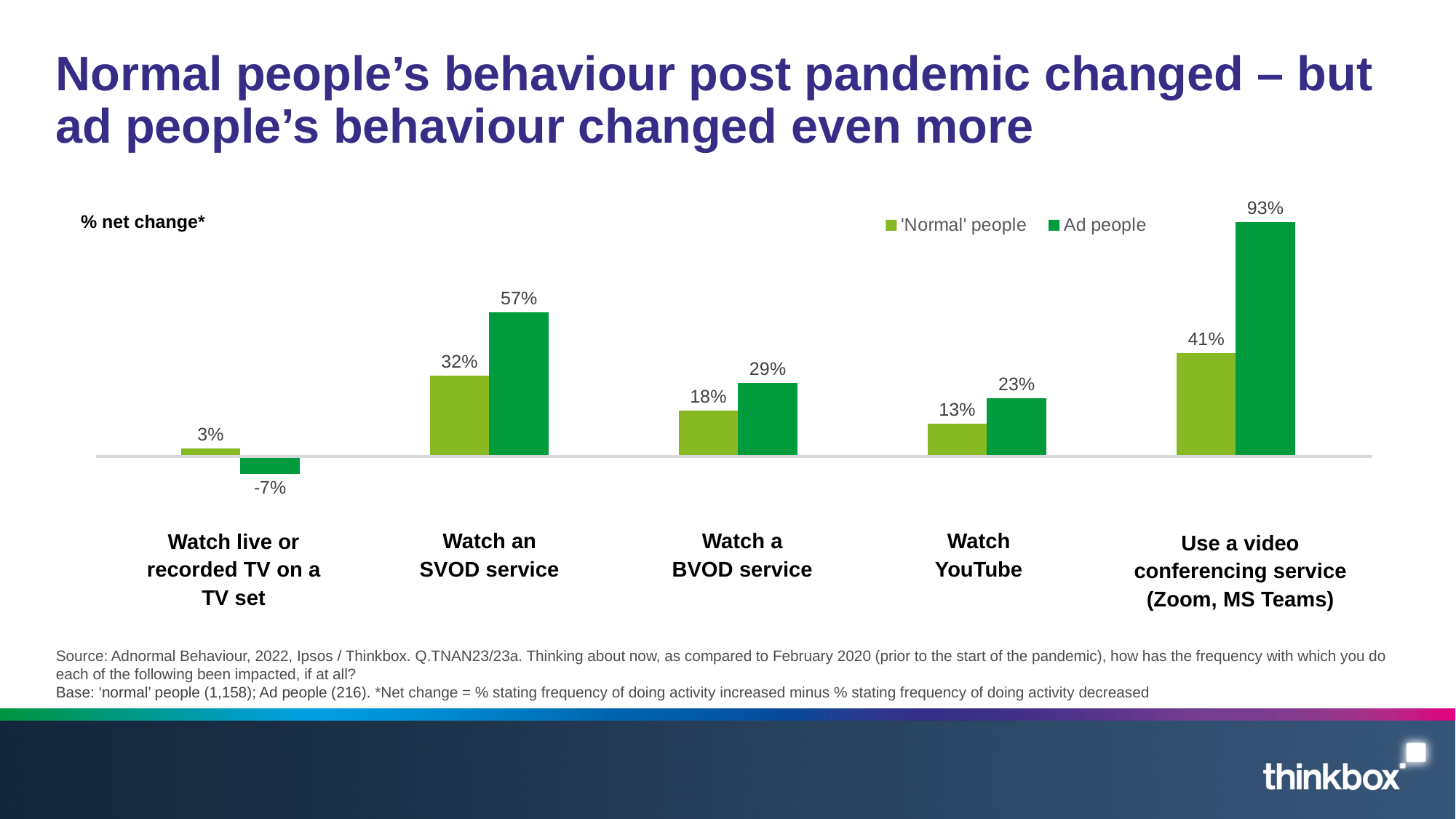
What is the % net change for Ad people for 'Use a video conferencing service (Zoom, MS Teams)'? 93% Which category has the lowest % net change for 'Normal' people? Watch live or recorded TV on a TV set How many series does the legend list? 2 What is the % net change for Ad people for 'Watch live or recorded TV on a TV set'? -7% What is the difference between Ad people and 'Normal' people for 'Use a video conferencing service (Zoom, MS Teams)'? 52 percentage points What kind of chart is shown on the slide? Bar chart How many categories are shown on the x axis of the chart? 5 What is the difference between Ad people and 'Normal' people for 'Watch an SVOD service'? 25 percentage points What is the % net change for 'Normal' people for 'Watch YouTube'? 13% For 'Watch a BVOD service', which group has the larger % net change, 'Normal' people or Ad people? Ad people Which category has the highest % net change for Ad people? Use a video conferencing service (Zoom, MS Teams) What is the % net change for 'Normal' people for 'Watch an SVOD service'? 32%